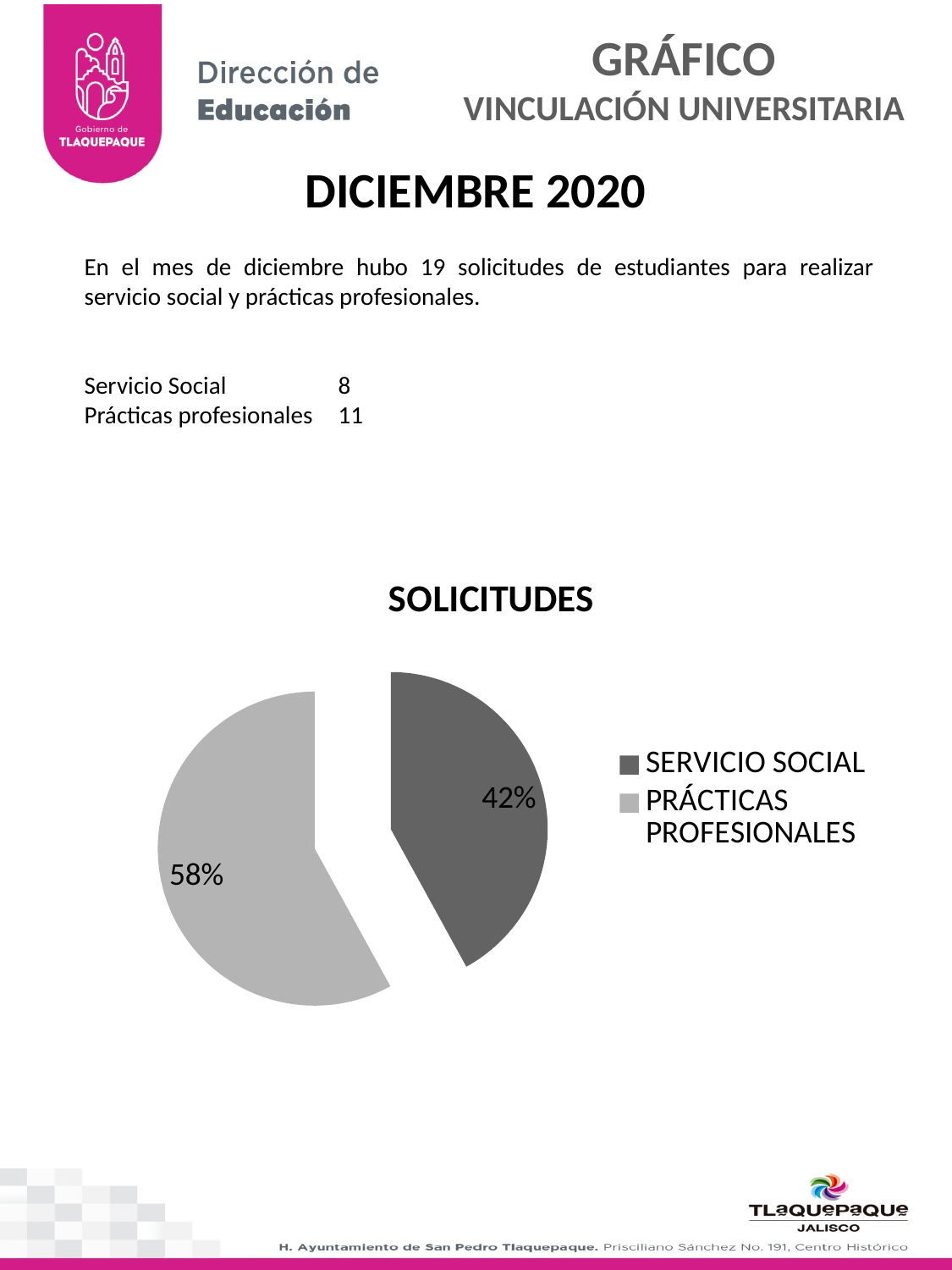
What is the difference in percentage points between the PRÁCTICAS PROFESIONALES and SERVICIO SOCIAL slices? 16% What is the title of the pie chart? SOLICITUDES How many entries does the legend of the SOLICITUDES pie chart list? 2 Which slice of the SOLICITUDES pie chart is the smallest? SERVICIO SOCIAL Which slice of the SOLICITUDES pie chart is the largest? PRÁCTICAS PROFESIONALES In the SOLICITUDES pie chart, which is larger: SERVICIO SOCIAL or PRÁCTICAS PROFESIONALES? PRÁCTICAS PROFESIONALES What percentage of the SOLICITUDES pie is SERVICIO SOCIAL? 42% Which legend entry is shown in the darker grey colour in the SOLICITUDES pie chart? SERVICIO SOCIAL How many slices does the SOLICITUDES pie chart have? 2 What percentage of the SOLICITUDES pie is PRÁCTICAS PROFESIONALES? 58% What kind of chart is shown under the title SOLICITUDES? pie chart Is the SERVICIO SOCIAL slice of the SOLICITUDES pie chart greater or less than 50%? less